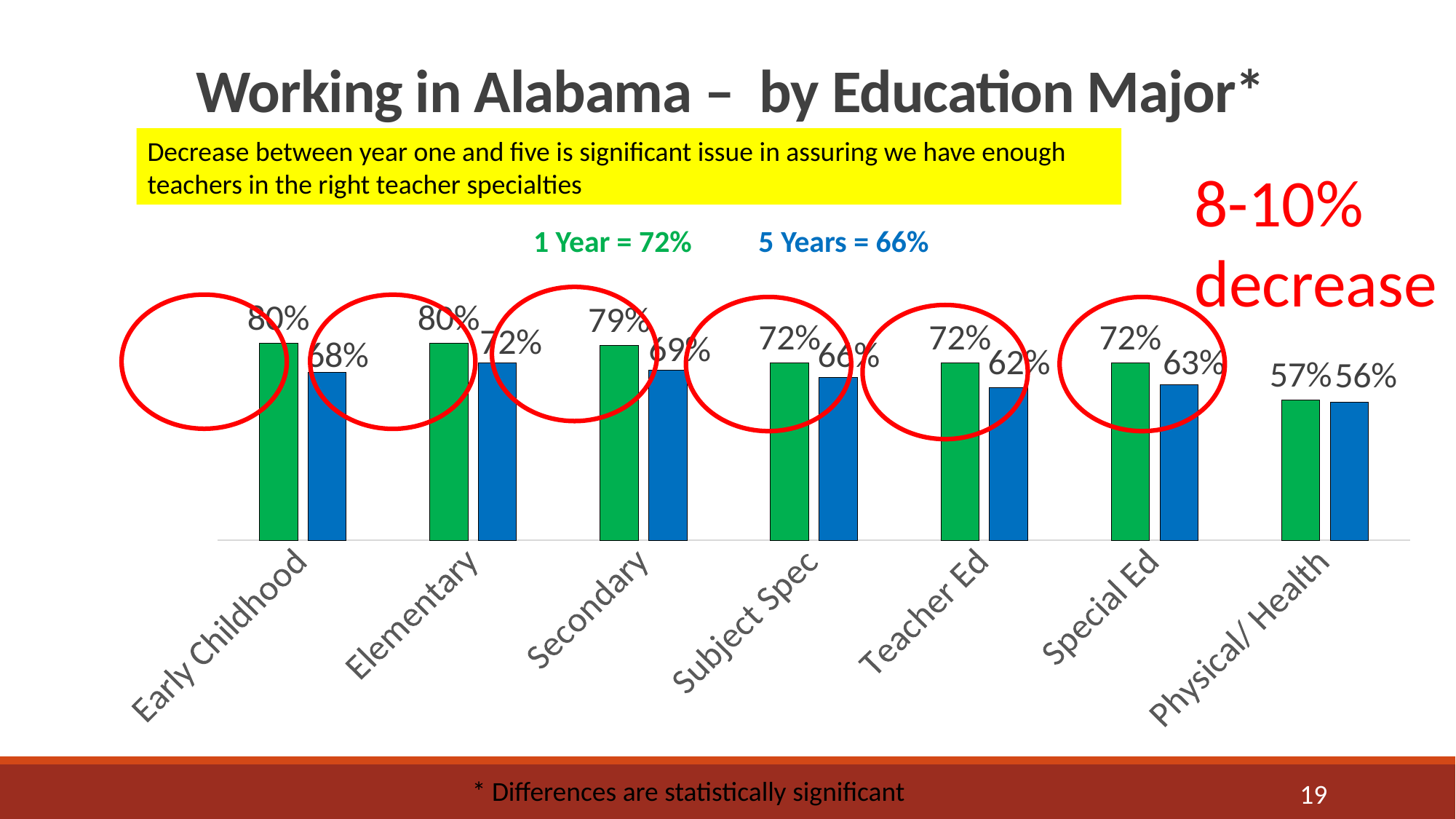
What is the 5 Years value for Teacher Ed? 62% How many series does the chart show? 2 What is the 1 Year value for Secondary? 79% Which colour represents the 5 Years series? Blue What is the difference between the 1 Year and 5 Years values for Special Ed? 9% How many education major categories are shown on the x axis? 7 What is the difference between the 1 Year and 5 Years values for Early Childhood? 12% Which is larger, the 5 Years value for Elementary or the 5 Years value for Subject Spec? Elementary Which category has the lowest 1 Year value? Physical/ Health What kind of chart is shown on the slide? Bar chart What is the 5 Years value for Early Childhood? 68% Which category has the highest 5 Years value? Elementary